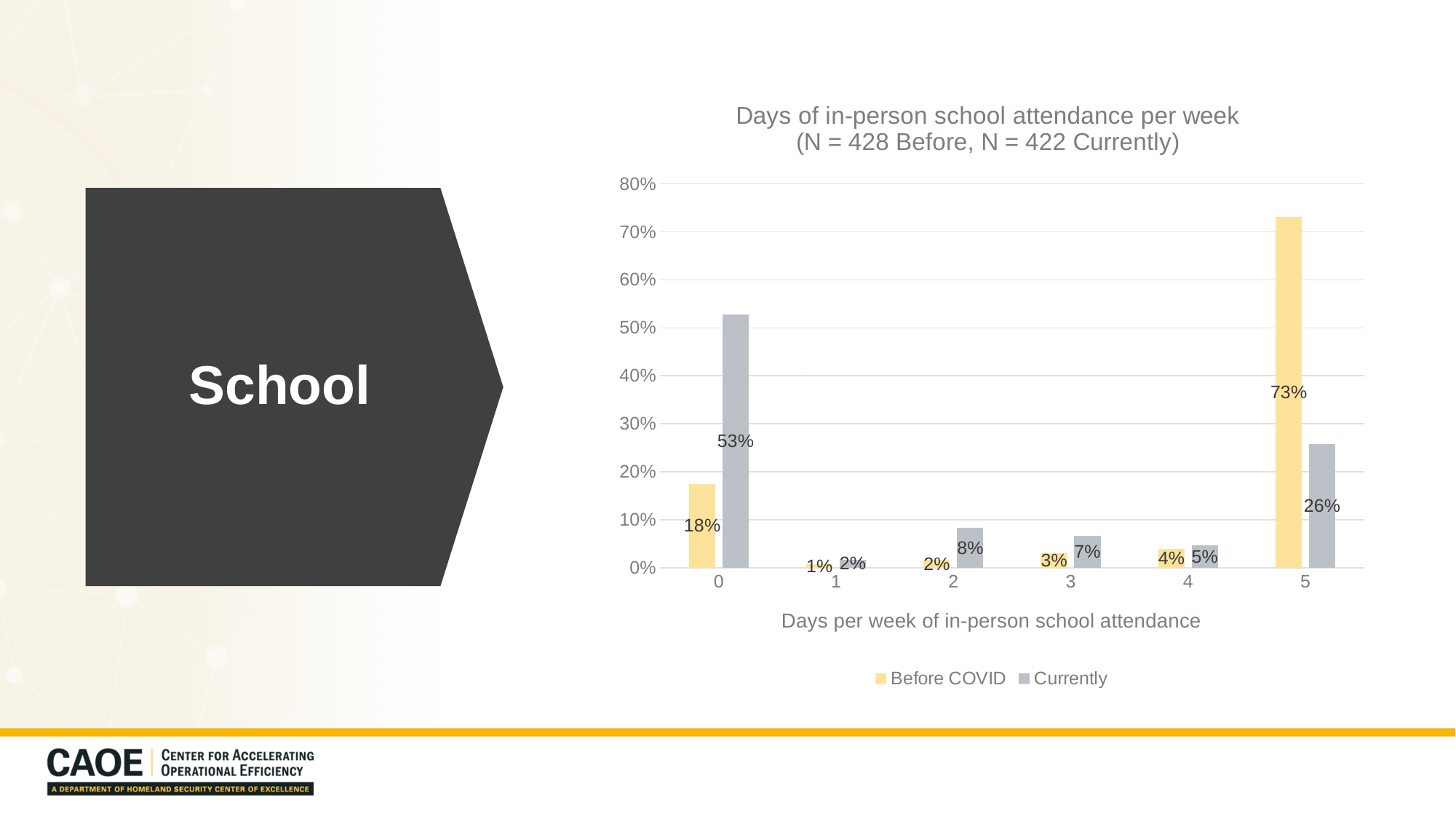
Which is larger for 0 days per week: the Before COVID value or the Currently value? Currently Which number of days per week has the lowest Before COVID value? 1 What is the difference between the Before COVID and Currently values for 5 days per week? 47% How many series does the legend list? 2 Which number of days per week has the highest Before COVID value? 5 What is the Currently value for 0 days per week of in-person school attendance? 53% What type of chart is shown on the slide? Bar chart What is the Before COVID value for 0 days per week? 18% How many categories of days per week are shown on the x axis? 6 What is the Before COVID value for 5 days per week of in-person school attendance? 73% What is the Currently value for 5 days per week? 26% Is the Currently value for 0 days per week greater or less than 50%? greater